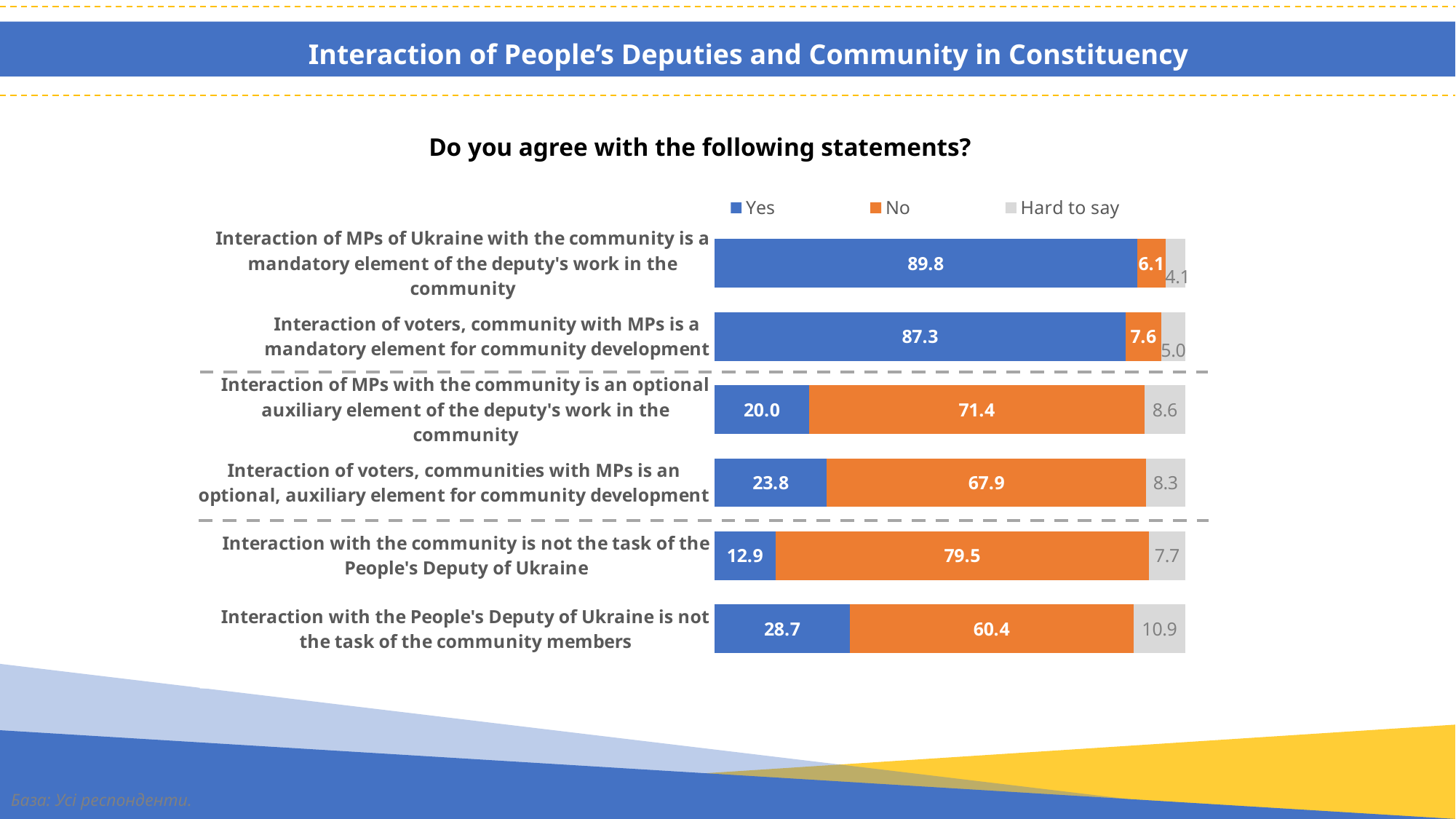
What type of chart is shown on the slide? Stacked bar chart What is the "No" value for the statement that interaction with the community is not the task of the People's Deputy of Ukraine? 79.5 Which is larger: the "No" value for the statement that interaction of MPs with the community is an optional auxiliary element, or the "No" value for the statement that interaction with the People's Deputy is not the task of the community members? Interaction of MPs with the community is an optional auxiliary element (71.4) What is the "Hard to say" value for the statement that interaction with the People's Deputy of Ukraine is not the task of the community members? 10.9 How many statements are shown in the chart? 6 What is the total of the stacked bar for the statement that interaction of MPs with the community is an optional auxiliary element of the deputy's work in the community? 100.0 What percentage of respondents answered "Yes" to the statement that interaction of MPs of Ukraine with the community is a mandatory element of the deputy's work in the community? 89.8 What is the difference between the "Yes" values for the two statements about interaction being a mandatory element (89.8 and 87.3)? 2.5 How many series does the legend list? 3 Which statement has the lowest "Yes" value? Interaction with the community is not the task of the People's Deputy of Ukraine Which statement has the highest "Yes" value? Interaction of MPs of Ukraine with the community is a mandatory element of the deputy's work in the community Which statement has the highest "Hard to say" value? Interaction with the People's Deputy of Ukraine is not the task of the community members